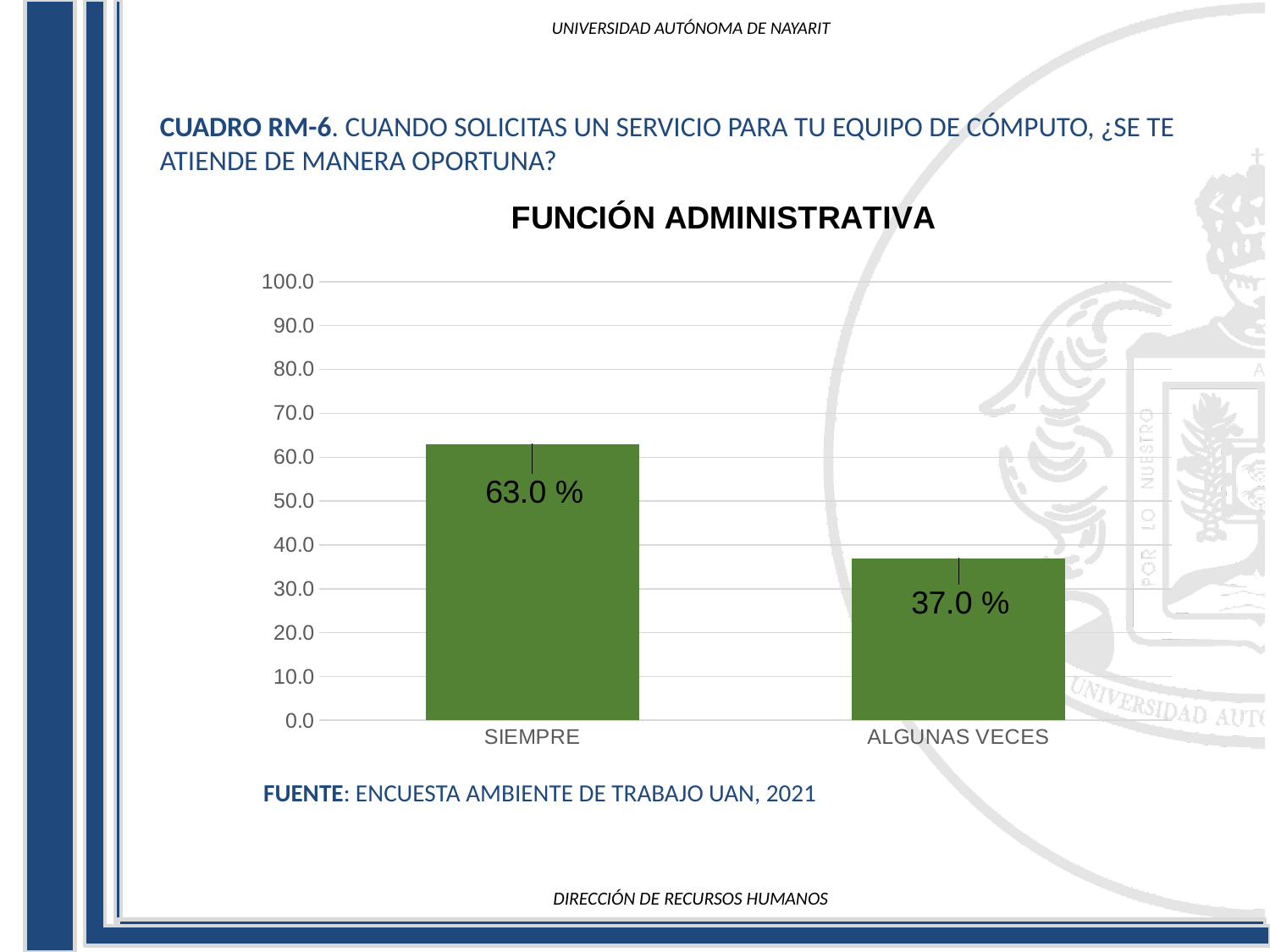
Is the value for ALGUNAS VECES greater or less than 40.0? less What kind of chart is shown? bar chart What is the difference between the values for SIEMPRE and ALGUNAS VECES? 26.0 % Which category has the lowest value? ALGUNAS VECES What is the value for ALGUNAS VECES? 37.0 % What is the value for SIEMPRE? 63.0 % What is the title of the chart? FUNCIÓN ADMINISTRATIVA Which category has the highest value? SIEMPRE Which is larger, the value for SIEMPRE or the value for ALGUNAS VECES? SIEMPRE How many categories are shown on the x axis? 2 What colour are the bars in the chart? green Is the value for SIEMPRE greater or less than 60.0? greater